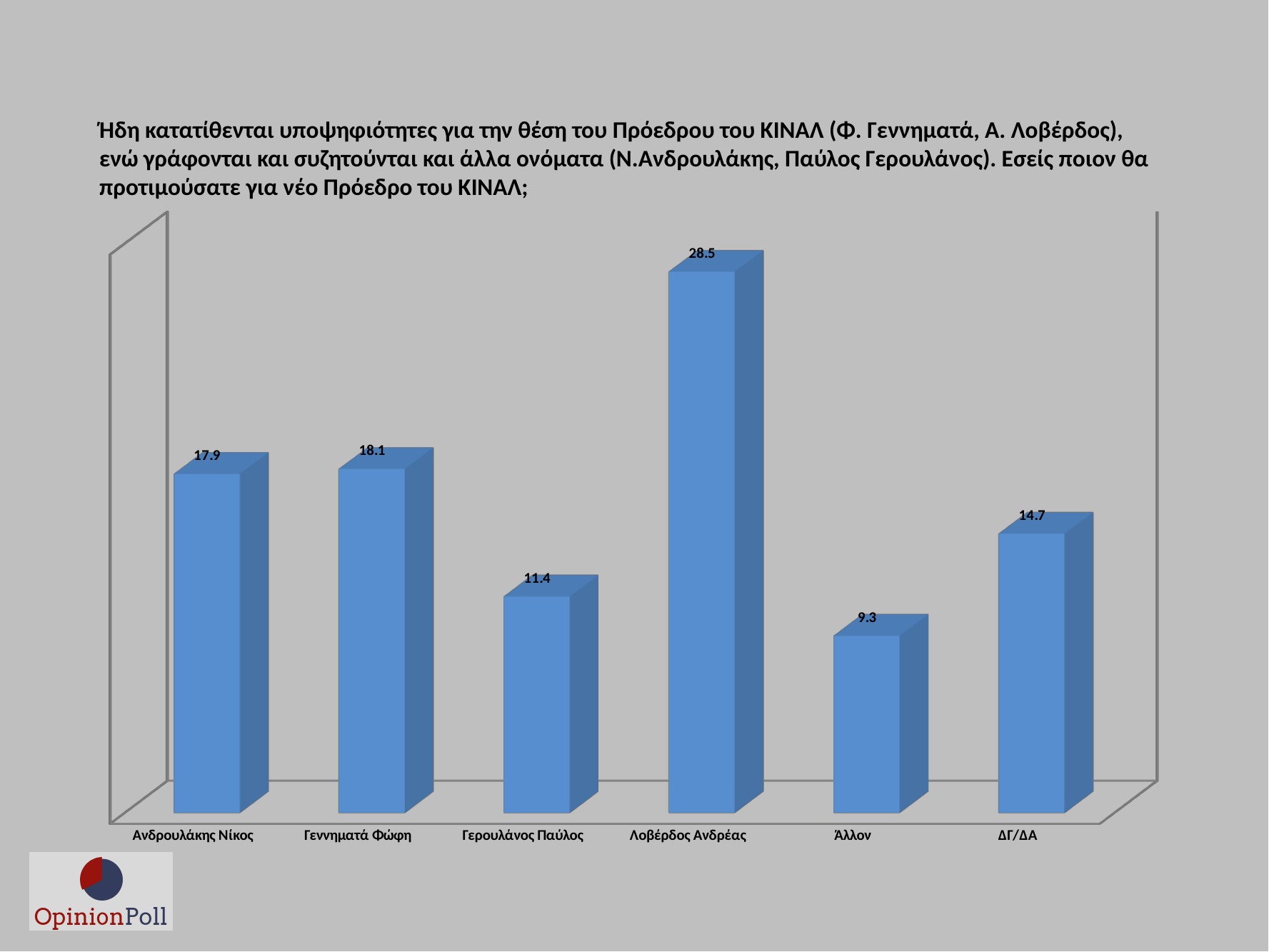
What kind of chart is shown on the slide? Bar chart Which category has the lowest value? Άλλον What value is shown for Λοβέρδος Ανδρέας? 28.5 What is the difference between the values for Λοβέρδος Ανδρέας and Γεννηματά Φώφη? 10.4 Which category has the highest value? Λοβέρδος Ανδρέας How many categories are shown on the chart? 6 What value is shown for ΔΓ/ΔΑ? 14.7 What value is shown for Ανδρουλάκης Νίκος? 17.9 What is the difference between the values for Γερουλάνος Παύλος and Άλλον? 2.1 Which is larger, the value for Γερουλάνος Παύλος or the value for ΔΓ/ΔΑ? ΔΓ/ΔΑ What value is shown for Άλλον? 9.3 What value is shown for Γεννηματά Φώφη? 18.1